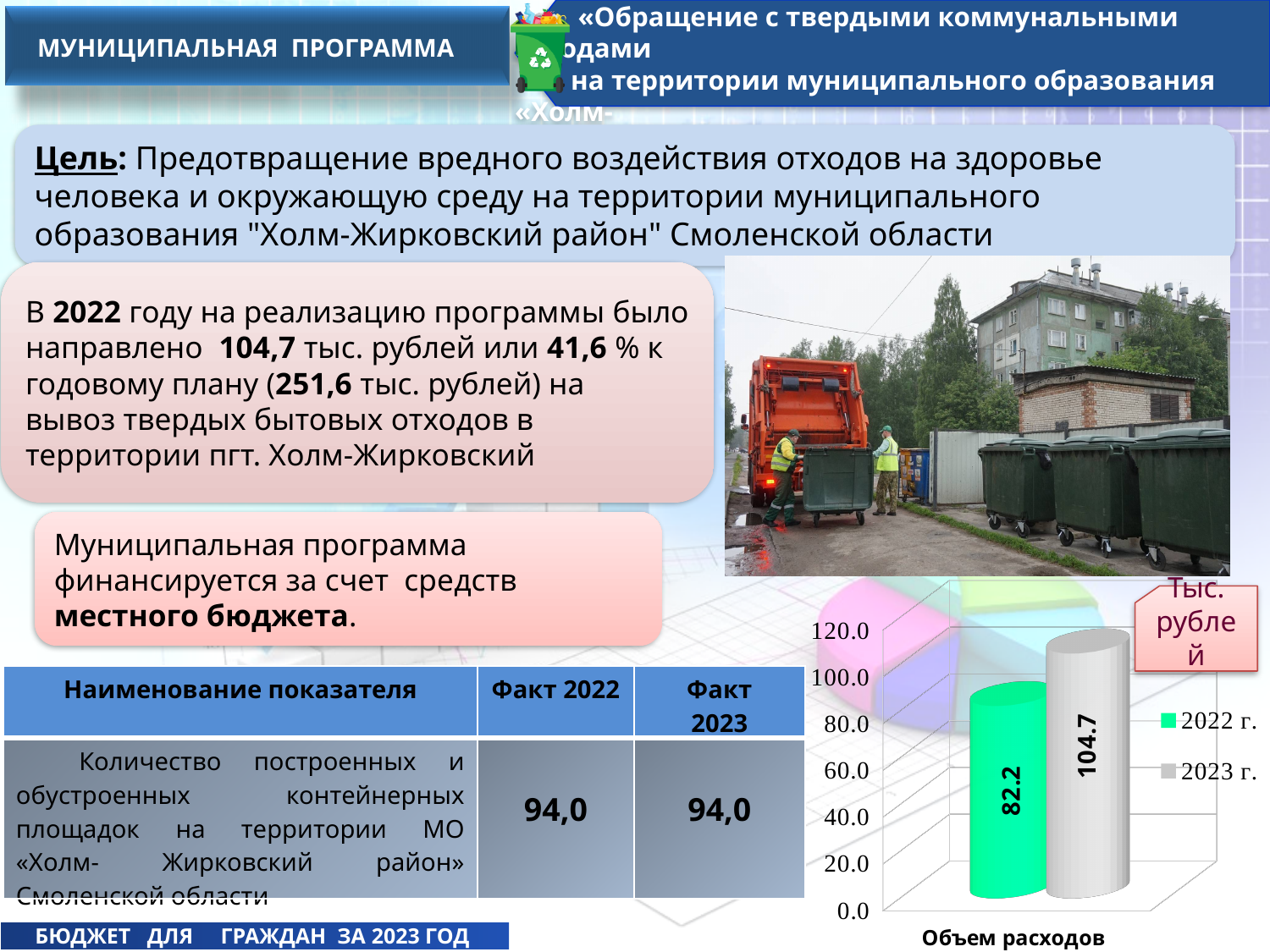
Is the value for 2023 г. greater or less than 100.0? greater What is the value for 2022 г. in the chart? 82.2 How many series does the chart legend list? 2 Which series has the highest value in the chart? 2023 г. Which series has the lowest value in the chart? 2022 г. What is the value for 2023 г. in the chart? 104.7 What is the difference between the 2023 г. and 2022 г. values in the chart? 22.5 Which series has the higher value in the chart, 2022 г. or 2023 г.? 2023 г. Is the value for 2022 г. greater or less than 100.0? less What is the maximum value shown on the chart's vertical axis? 120.0 What kind of chart is shown on the slide? bar chart What is the category label shown on the x axis of the chart? Объем расходов